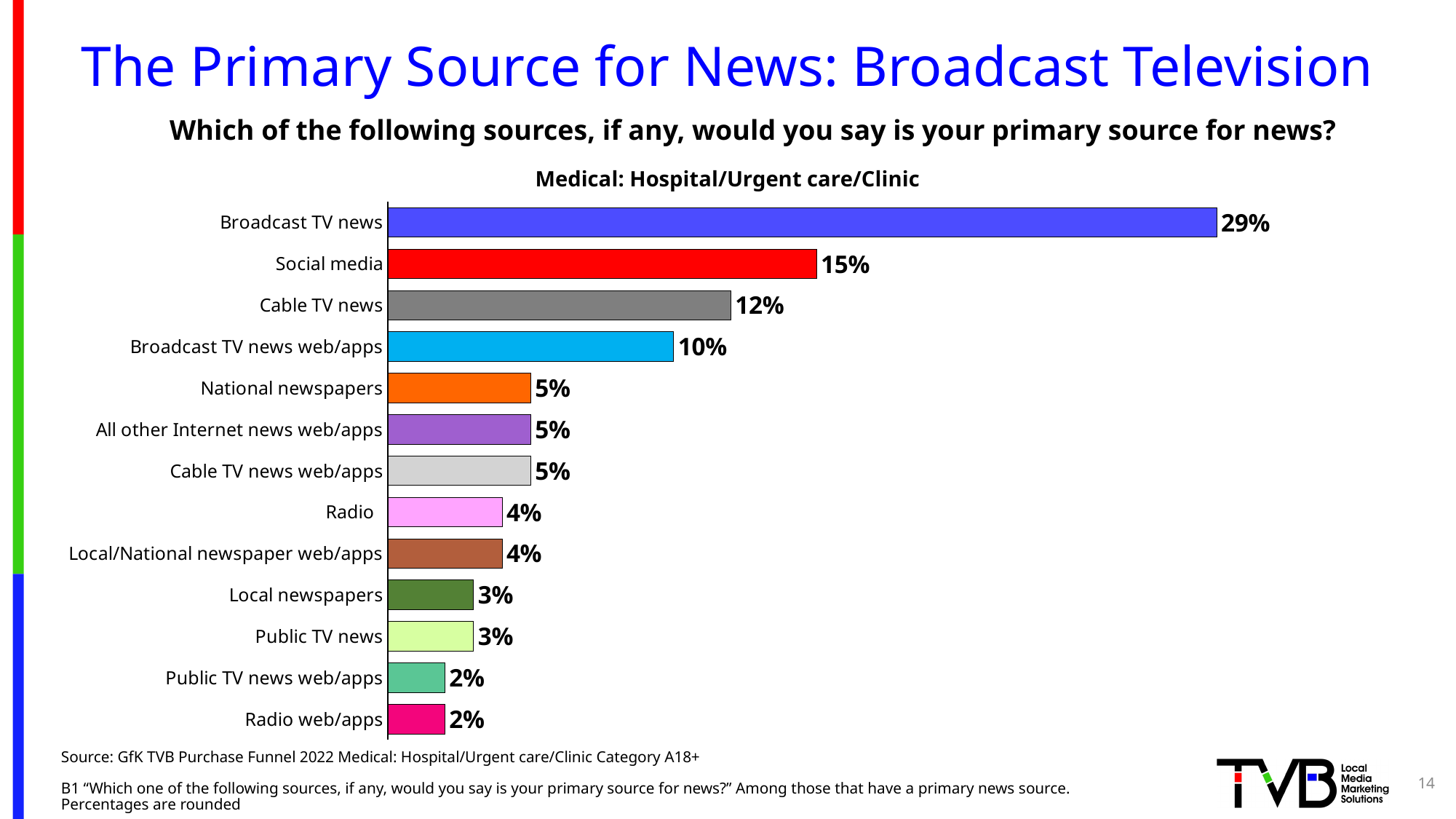
What is the value shown for Social media? 15% How many news source categories are shown in the chart? 13 What is the difference in percentage points between Broadcast TV news and Social media? 14 What is the value for Broadcast TV news web/apps? 10% What percentage of respondents named Broadcast TV news as their primary source for news? 29% What is the chart's title? Medical: Hospital/Urgent care/Clinic What percentage is shown for Cable TV news? 12% What colour is the bar for Social media? Red Which is larger, the value for Social media or the value for Cable TV news? Social media What type of chart is shown on the slide? Bar chart Which news source has the highest percentage in the chart? Broadcast TV news What is the difference between Cable TV news and Broadcast TV news web/apps? 2